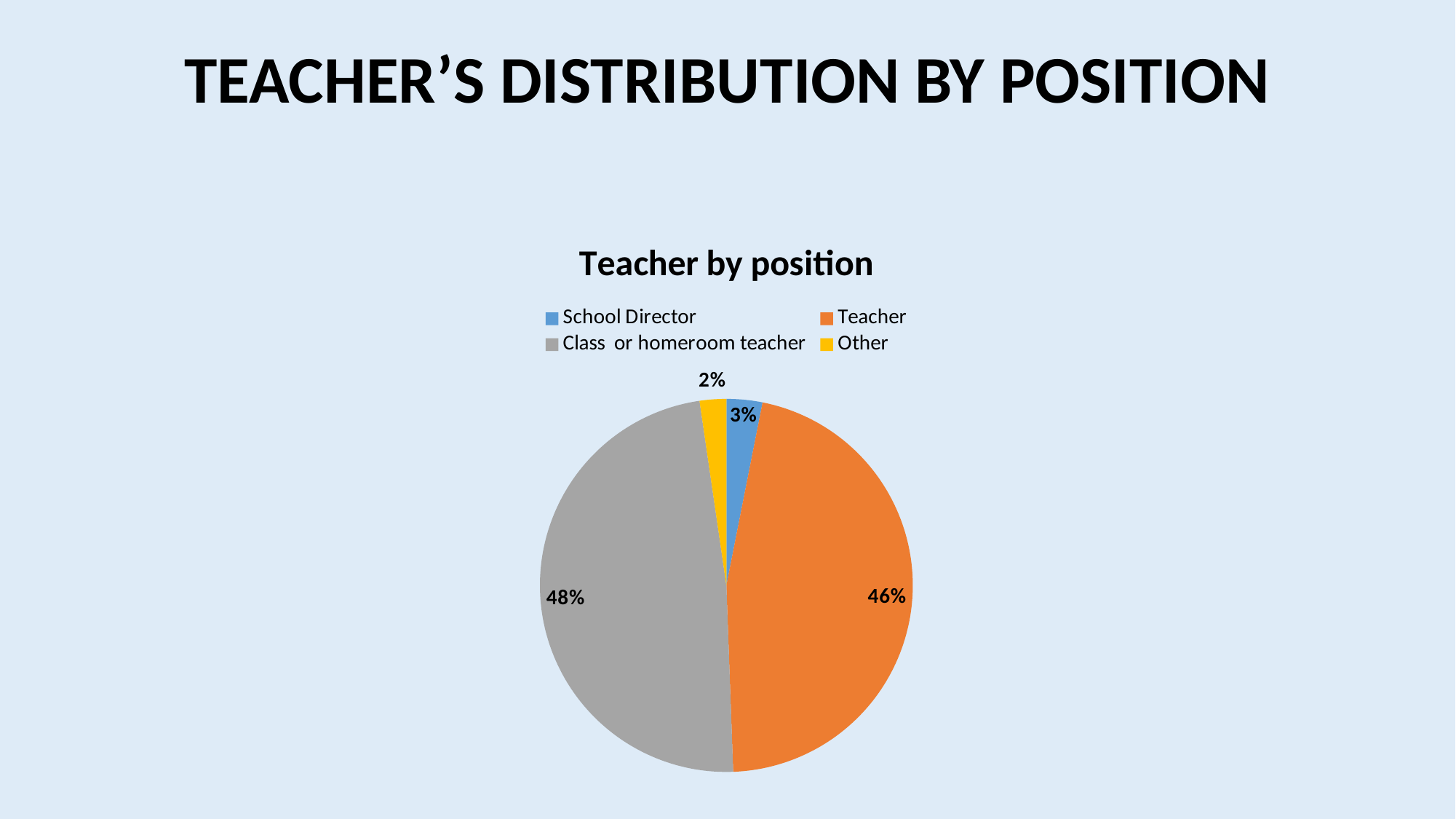
What share of the pie is labelled for Other? 2% What is the title of the chart? Teacher by position Which colour represents Teacher in the pie chart? Orange Which position has the smallest share of the pie? Other What is the difference between the shares for Class or homeroom teacher and Teacher? 2% How many categories does the pie chart have? 4 Which position has the largest share of the pie? Class or homeroom teacher What type of chart is shown on the slide? Pie chart What share of the pie is labelled for Teacher? 46% What share of the pie is labelled for School Director? 3% Which is larger, the share for School Director or the share for Other? School Director